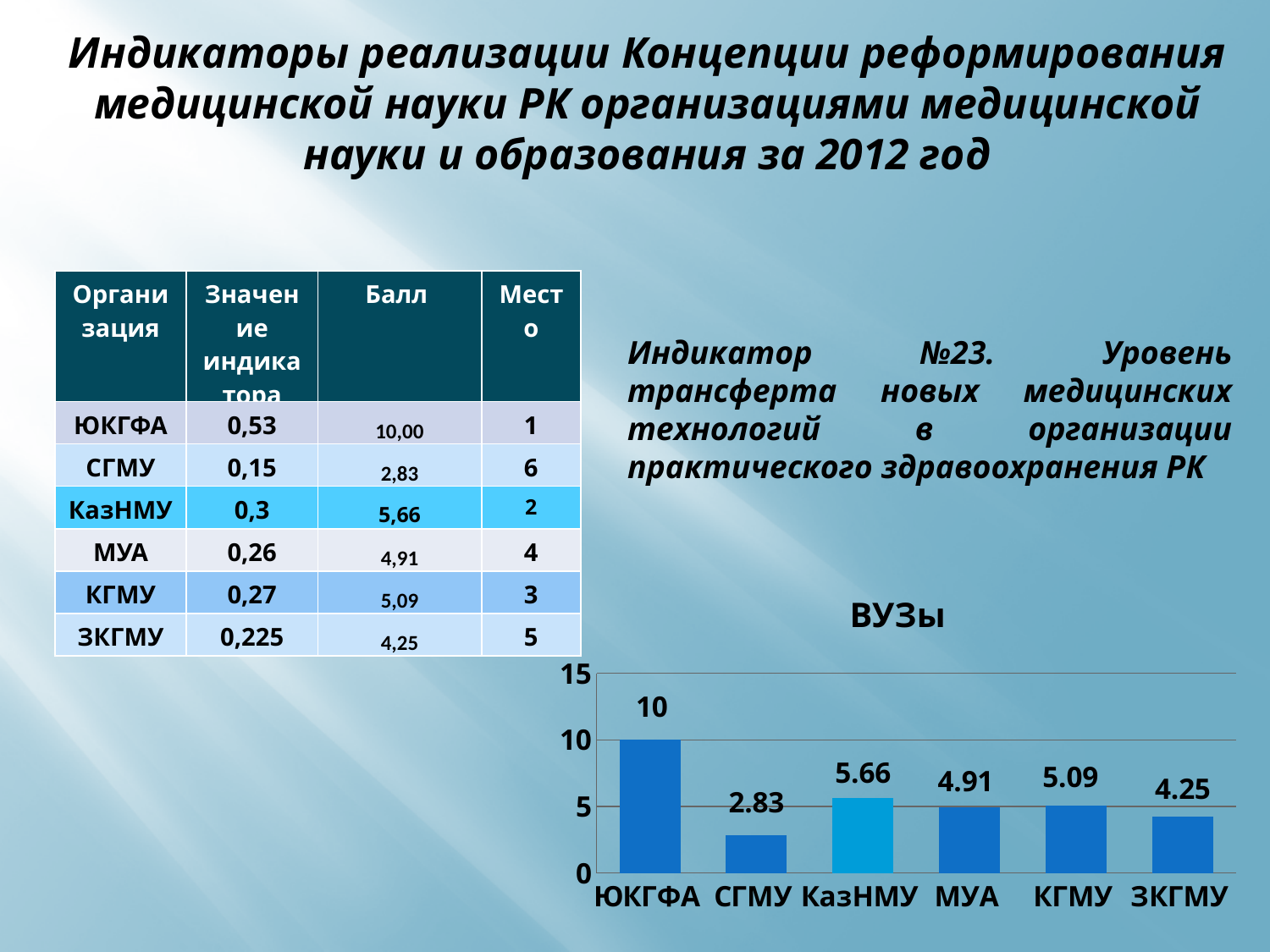
What is the difference between the values for КГМУ and МУА in the ВУЗы chart? 0.18 Which category has the highest value in the ВУЗы chart? ЮКГФА How many categories are shown in the ВУЗы chart? 6 What kind of chart is the ВУЗы chart? bar chart Which is larger in the ВУЗы chart, the value for КазНМУ or the value for ЗКГМУ? КазНМУ Which category has the lowest value in the ВУЗы chart? СГМУ What is the value for СГМУ in the ВУЗы chart? 2.83 What is the title of the chart on the slide? ВУЗы What is the value for ЮКГФА in the ВУЗы chart? 10 What is the value for КазНМУ in the ВУЗы chart? 5.66 What is the difference between the values for ЮКГФА and СГМУ in the ВУЗы chart? 7.17 What is the value for ЗКГМУ in the ВУЗы chart? 4.25